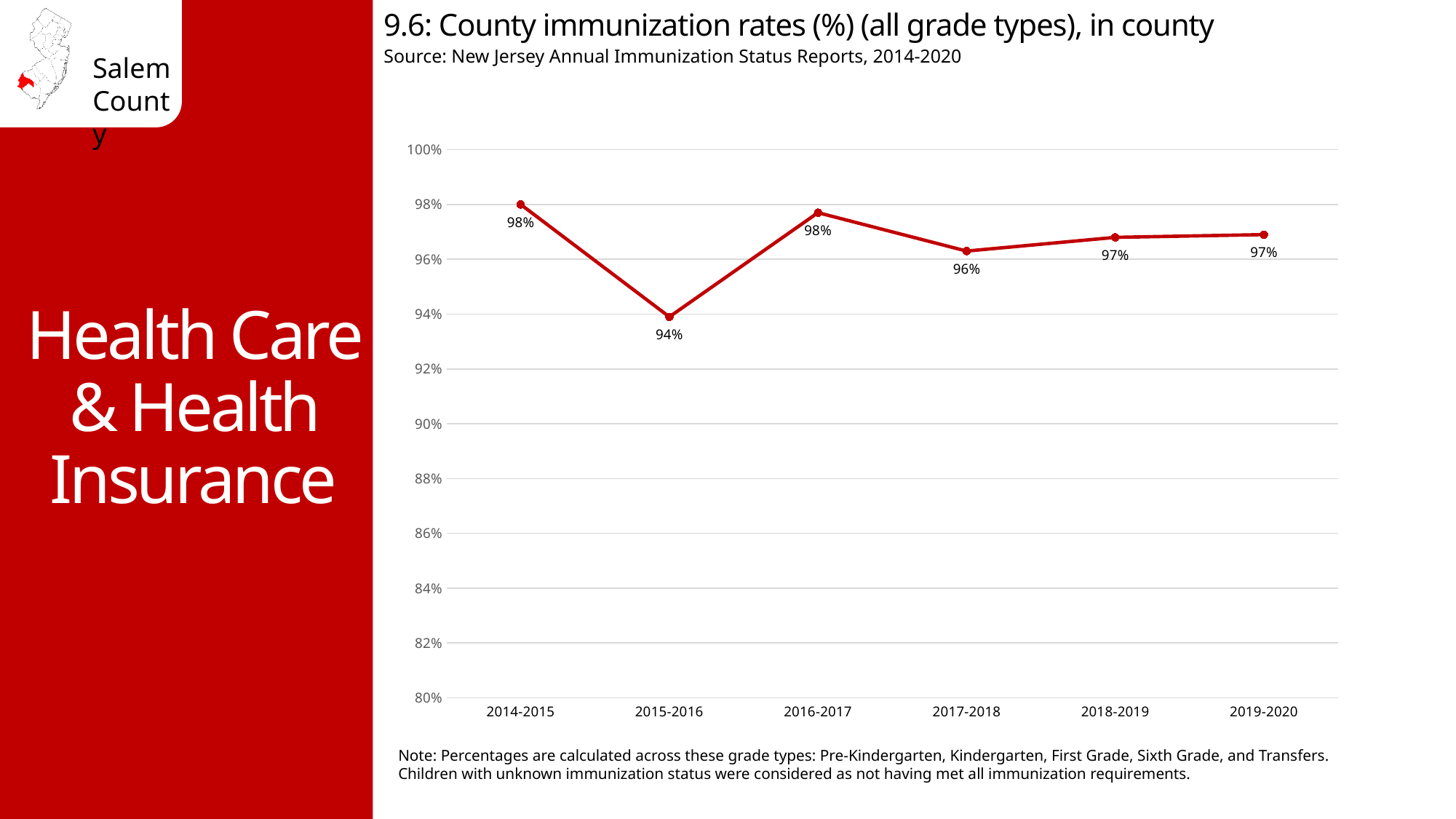
What is the difference between the immunization rate in 2014-2015 and in 2015-2016? 4 percentage points Is the immunization rate for 2015-2016 greater or less than 96%? less What is the county immunization rate for 2019-2020? 97% Which is larger, the immunization rate for 2015-2016 or for 2017-2018? 2017-2018 What kind of chart is shown on the slide? line chart What is the county immunization rate for 2017-2018? 96% Does the immunization rate rise or fall from 2014-2015 to 2015-2016? fall What is the county immunization rate for 2014-2015? 98% What is the county immunization rate for 2015-2016? 94% What is the source cited for the chart? New Jersey Annual Immunization Status Reports, 2014-2020 How many school years are plotted on the chart? 6 Which school year has the lowest immunization rate? 2015-2016